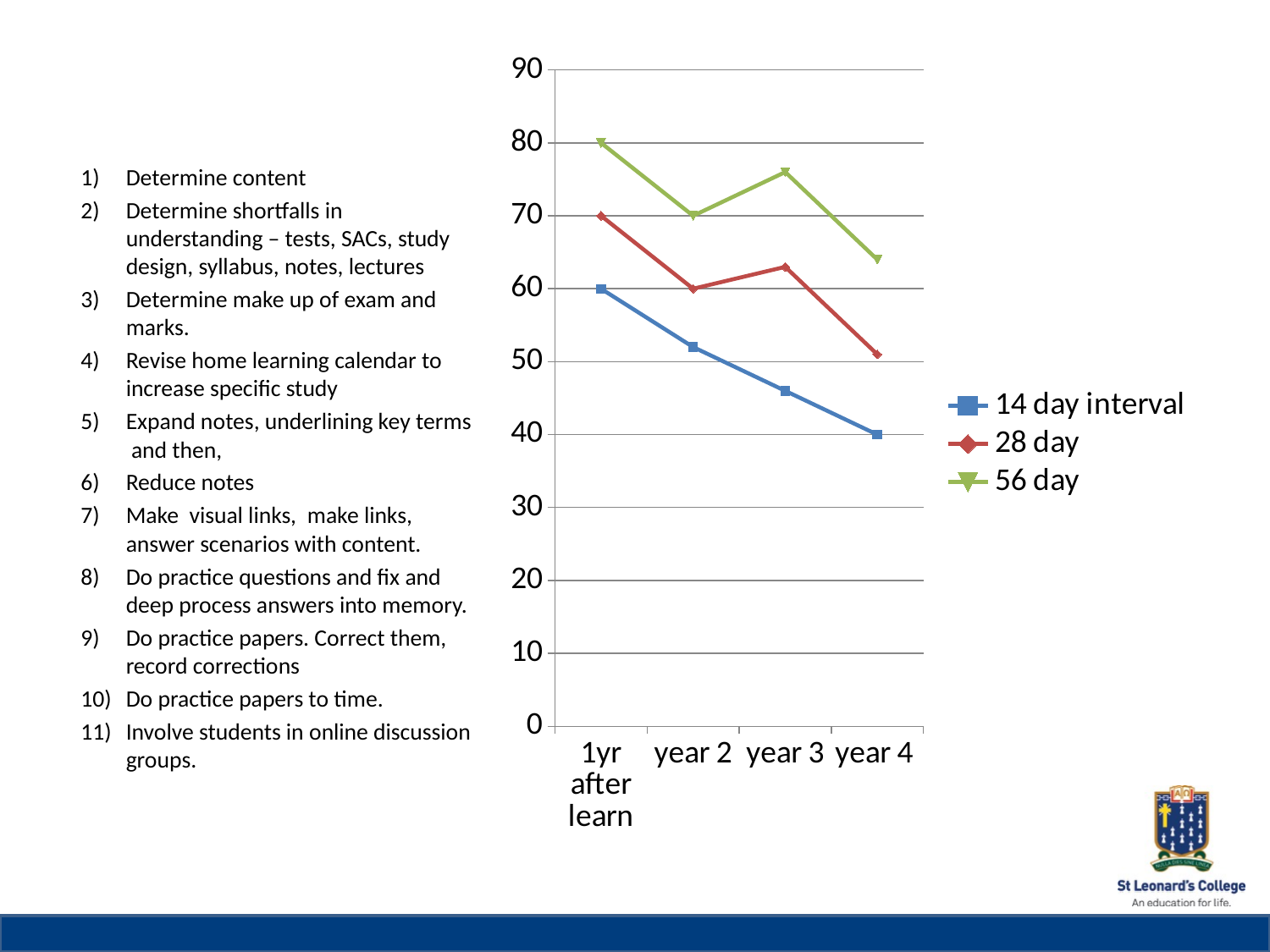
Which series has the highest value at 1yr after learn? 56 day Is the value for the 14 day interval series at year 3 greater or less than 50? less What type of chart is shown on the slide? line chart Which is larger at year 2: the 28 day series or the 14 day interval series? 28 day How many categories are shown along the x axis? 4 How many series does the legend list? 3 What is the value for the 56 day series at 1yr after learn? 80 Does the 14 day interval series rise or fall from 1yr after learn to year 4? fall What is the value for the 14 day interval series at 1yr after learn? 60 What is the value for the 14 day interval series at year 4? 40 Which series has the lowest value at year 4? 14 day interval Is the value for the 56 day series at year 3 greater or less than 70? greater